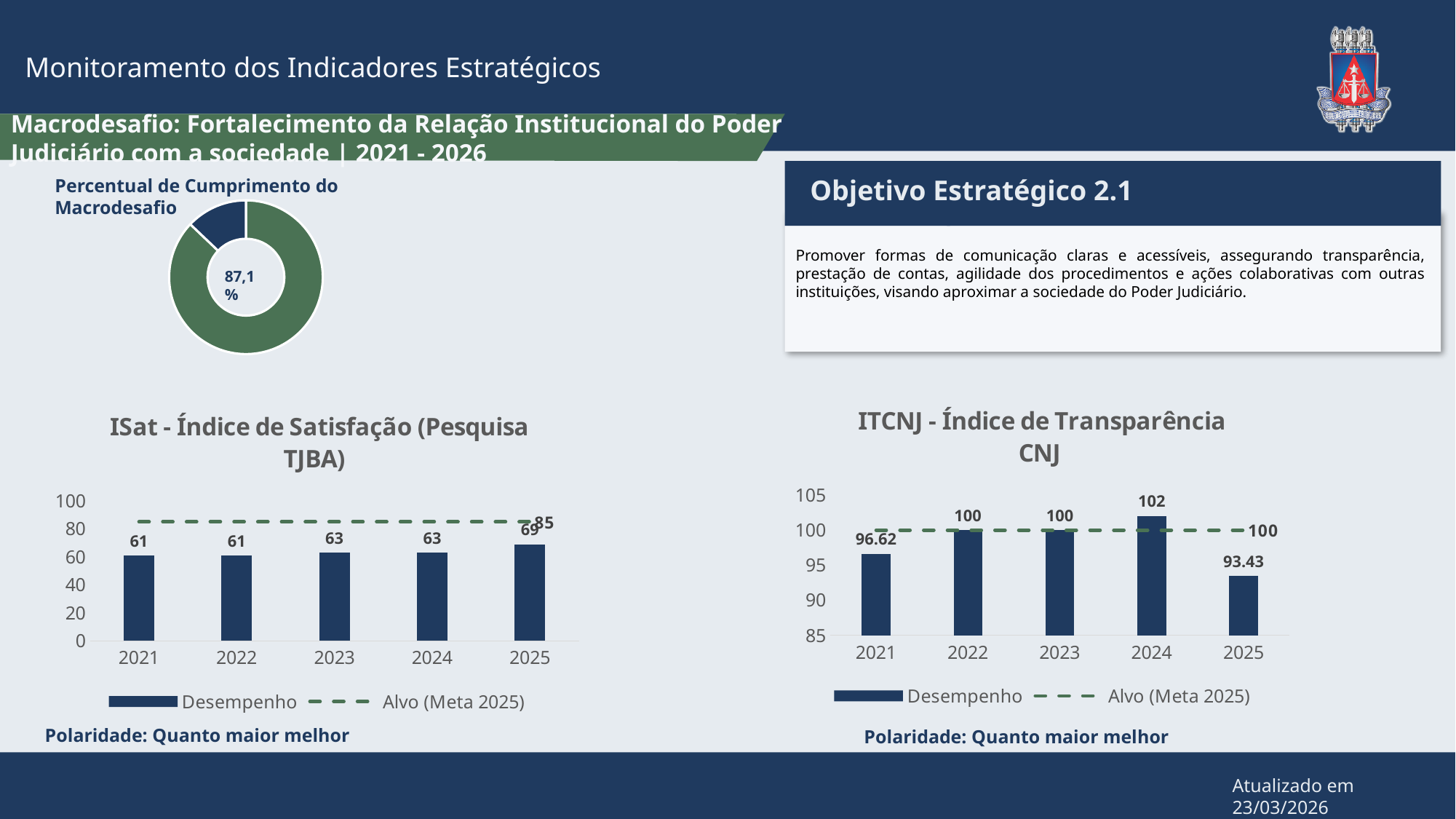
In the ISat - Índice de Satisfação (Pesquisa TJBA) chart, how many years are shown on the x axis? 5 In the ISat - Índice de Satisfação (Pesquisa TJBA) chart, what is the Alvo (Meta 2025) value? 85 In the ISat - Índice de Satisfação (Pesquisa TJBA) chart, what is the Desempenho value for 2025? 69 In the ISat - Índice de Satisfação (Pesquisa TJBA) chart, which year has the highest Desempenho value? 2025 What value is shown in the centre of the Percentual de Cumprimento do Macrodesafio donut chart? 87,1% In the ITCNJ - Índice de Transparência CNJ chart, which year has the highest Desempenho value? 2024 In the ITCNJ - Índice de Transparência CNJ chart, what is the Desempenho value for 2021? 96.62 In the ITCNJ - Índice de Transparência CNJ chart, which year has the lowest Desempenho value? 2025 In the ITCNJ - Índice de Transparência CNJ chart, is the Desempenho value for 2024 larger or smaller than the value for 2021? larger In the ITCNJ - Índice de Transparência CNJ chart, how many series does the legend list? 2 In the ITCNJ - Índice de Transparência CNJ chart, what is the Desempenho value for 2025? 93.43 In the ISat - Índice de Satisfação (Pesquisa TJBA) chart, what is the difference between the Desempenho values for 2025 and 2021? 8